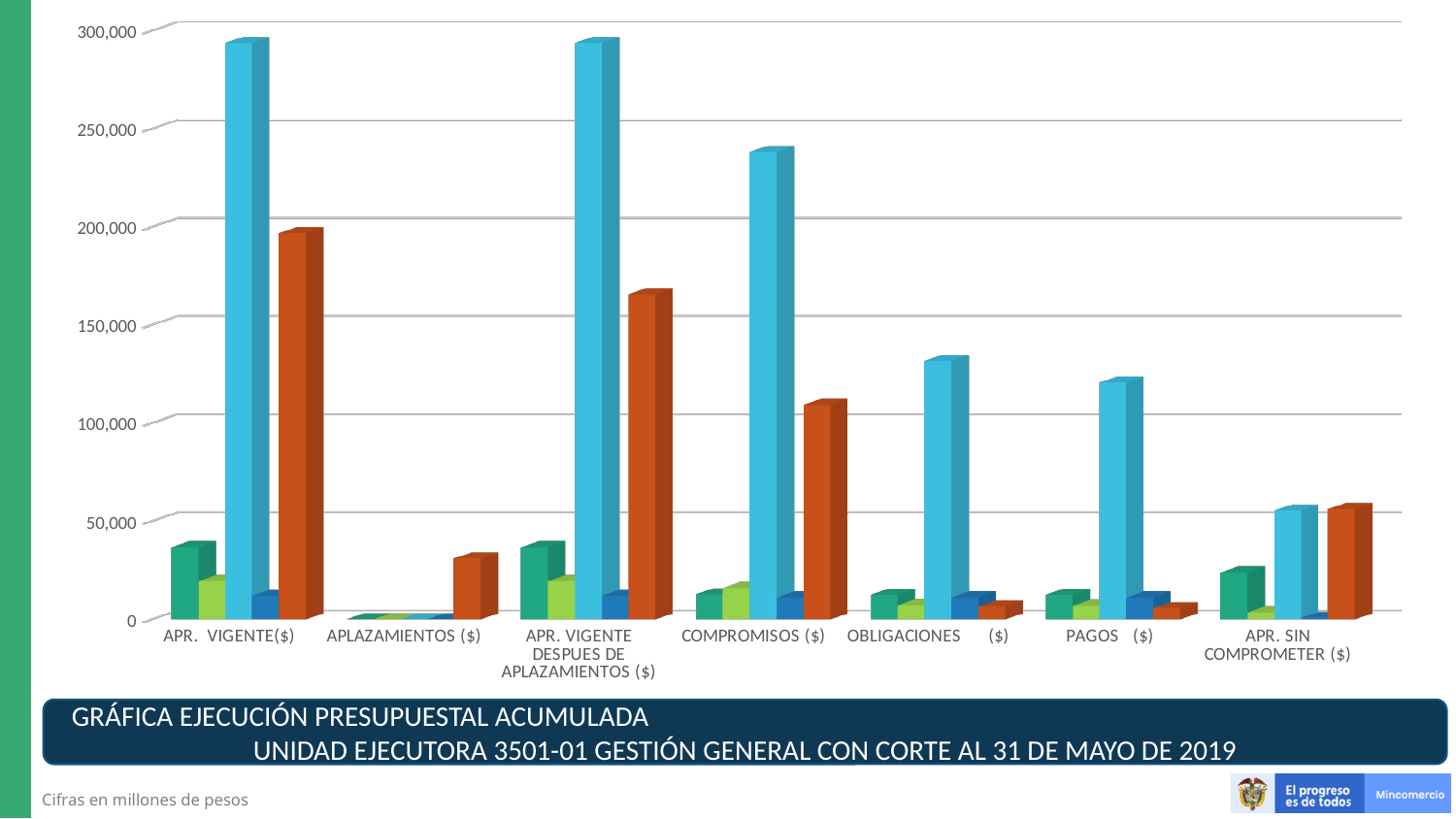
Is the light blue bar for APR. VIGENTE($) greater or less than 250,000? greater Which is larger, the orange bar for APR. VIGENTE($) or the orange bar for COMPROMISOS ($)? APR. VIGENTE($) Which is larger, the light blue bar for COMPROMISOS ($) or the light blue bar for OBLIGACIONES ($)? COMPROMISOS ($) What kind of chart is shown on the slide? Bar chart Do the light blue bars rise or fall moving from COMPROMISOS ($) to OBLIGACIONES ($) to PAGOS ($)? fall How many categories are shown along the x axis of the chart? 7 Is the light blue bar for COMPROMISOS ($) greater or less than 200,000? greater Is the orange bar for APLAZAMIENTOS ($) greater or less than 50,000? less What is the highest value shown on the vertical axis of the chart? 300,000 According to the note below the chart, in what units are the figures expressed? Millones de pesos